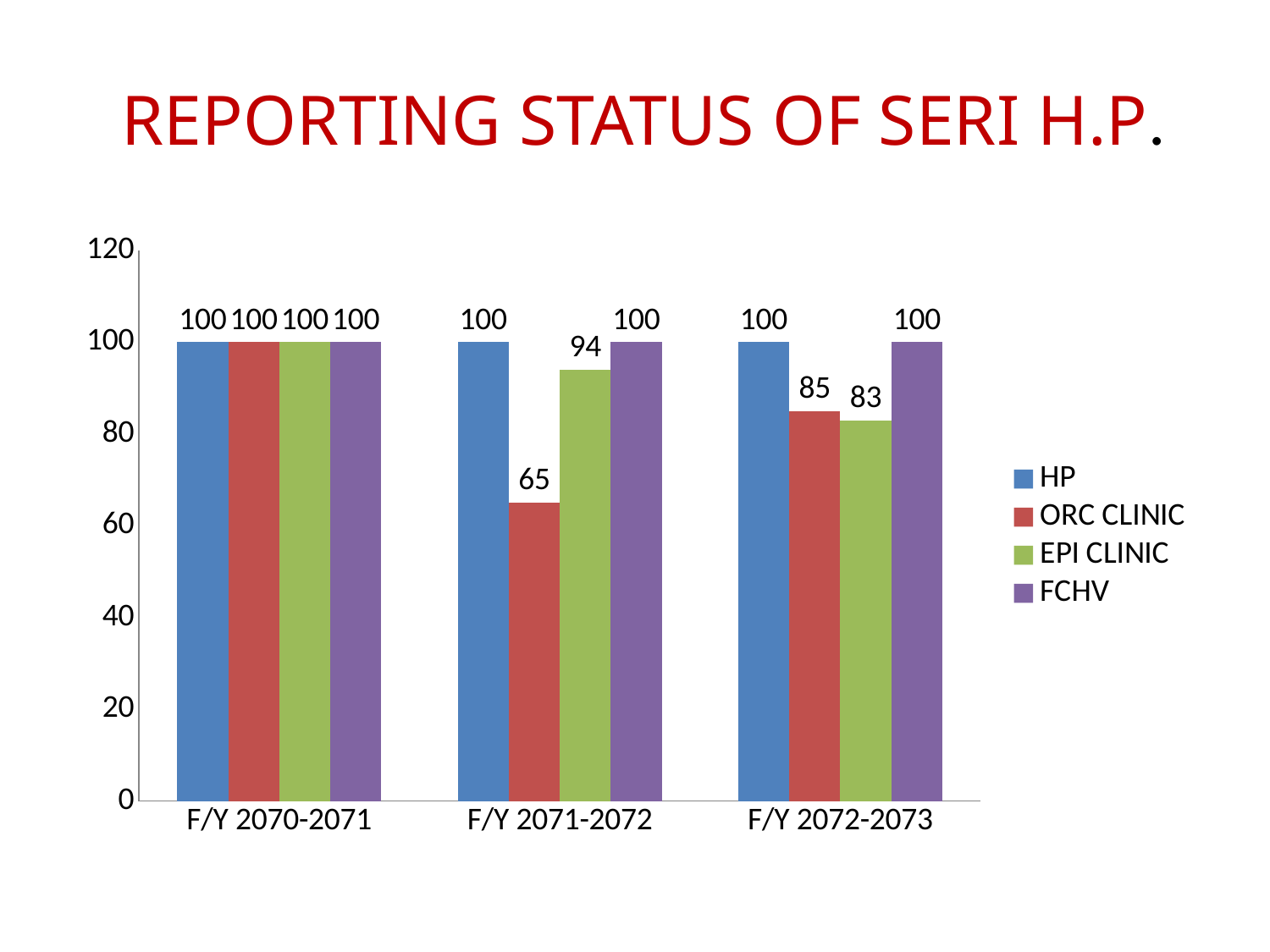
What kind of chart is shown on the slide? Bar chart What is the value for EPI CLINIC in F/Y 2071-2072? 94 What is the difference between the HP value and the ORC CLINIC value in F/Y 2071-2072? 35 Which series has the lowest value in F/Y 2072-2073? EPI CLINIC How many fiscal year categories are shown on the x axis? 3 How many series does the legend list? 4 What is the value for ORC CLINIC in F/Y 2072-2073? 85 What is the value for ORC CLINIC in F/Y 2071-2072? 65 Does the ORC CLINIC value rise or fall from F/Y 2070-2071 to F/Y 2071-2072? Fall Which series has the lowest value in F/Y 2071-2072? ORC CLINIC What is the value for EPI CLINIC in F/Y 2072-2073? 83 Which is larger: the ORC CLINIC value in F/Y 2071-2072 or the ORC CLINIC value in F/Y 2072-2073? F/Y 2072-2073